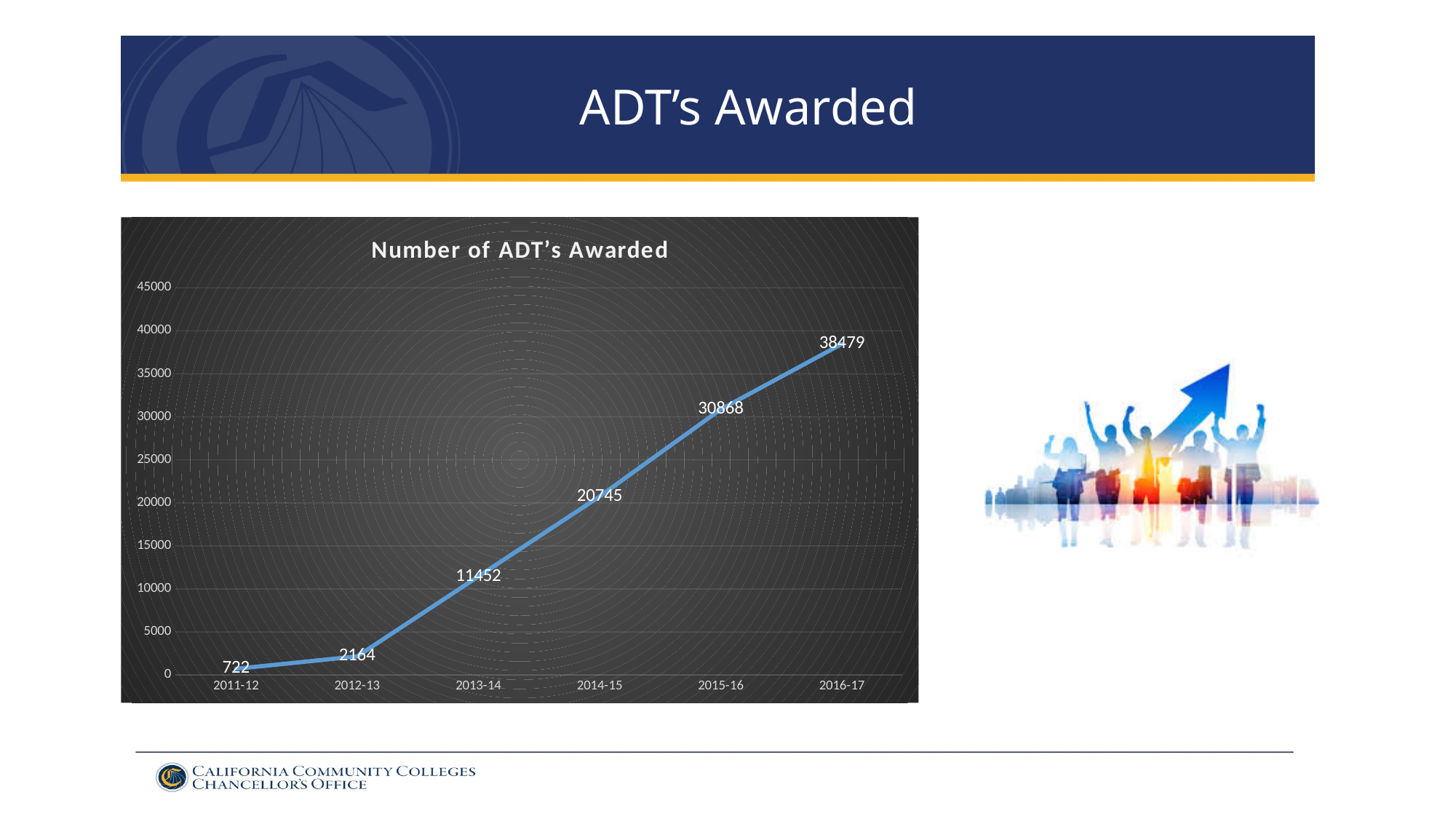
Do the values rise or fall from 2011-12 to 2016-17? rise What is the number of ADT's awarded in 2013-14? 11452 Which year had more ADT's awarded, 2013-14 or 2014-15? 2014-15 How many years are shown on the x axis of the chart? 6 What kind of chart is shown on the slide? line chart Which year has the lowest number of ADT's awarded? 2011-12 What is the number of ADT's awarded in 2016-17? 38479 Is the value for 2015-16 greater or less than 30000? greater What is the difference between the number of ADT's awarded in 2012-13 and 2011-12? 1442 Which year has the highest number of ADT's awarded? 2016-17 What is the difference between the number of ADT's awarded in 2015-16 and 2014-15? 10123 What is the number of ADT's awarded in 2011-12? 722